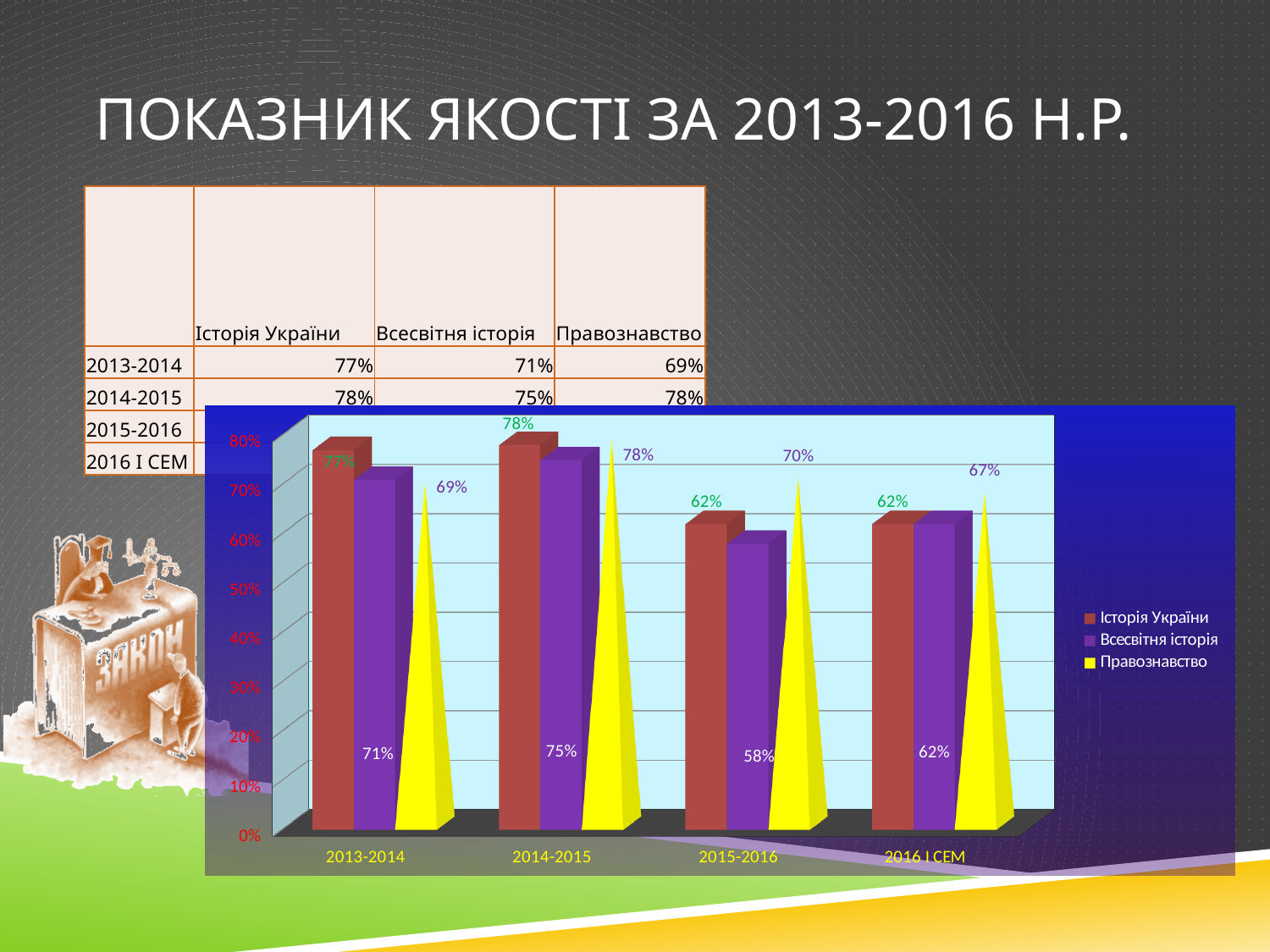
What is the value for Всесвітня історія in 2015-2016? 58% Does the value for Історія України rise or fall from 2014-2015 to 2016 І СЕМ? fall What is the value for Правознавство in 2016 І СЕМ? 67% In which category is the value for Правознавство highest? 2014-2015 What type of chart is shown on the slide? bar chart What is the value for Історія України in 2014-2015? 78% How many series does the chart legend list? 3 How many categories are shown on the x axis of the chart? 4 Which is larger in 2015-2016: the value for Правознавство or the value for Історія України? Правознавство What is the difference between the Історія України values for 2014-2015 and 2015-2016? 16% In which category is the value for Всесвітня історія lowest? 2015-2016 What is the value for Всесвітня історія in 2013-2014? 71%